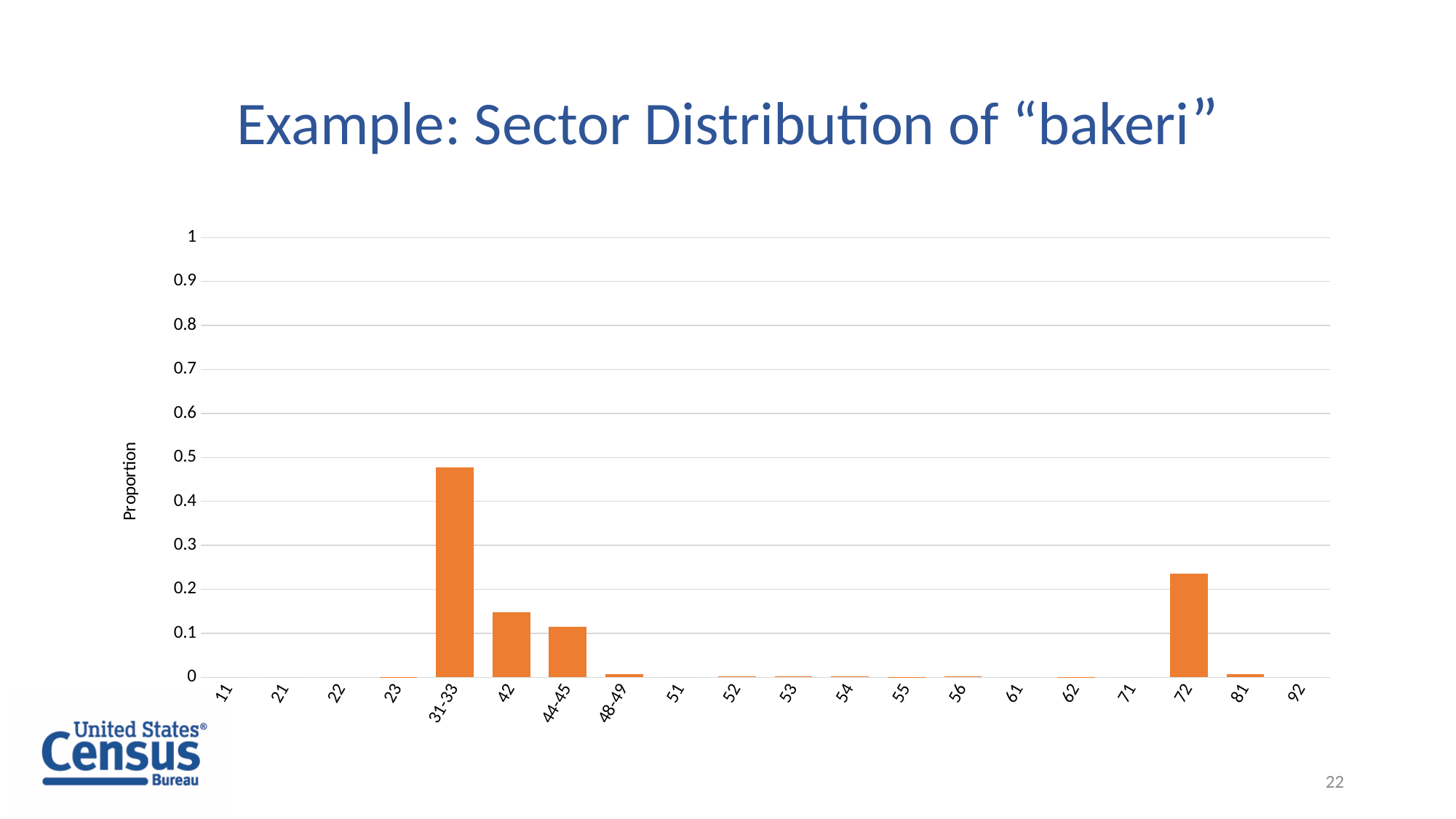
What is the label of the y axis of the chart? Proportion Is the proportion for sector 44-45 greater or less than 0.2? less Is the proportion for sector 31-33 greater or less than 0.4? greater Is the proportion for sector 72 greater or less than 0.2? greater Which sector has the larger proportion, 42 or 44-45? 42 What kind of chart is shown on the slide? bar chart Which sector has the highest proportion in the chart? 31-33 How many sector categories are shown on the x axis of the chart? 20 Which sector has the larger proportion, 72 or 42? 72